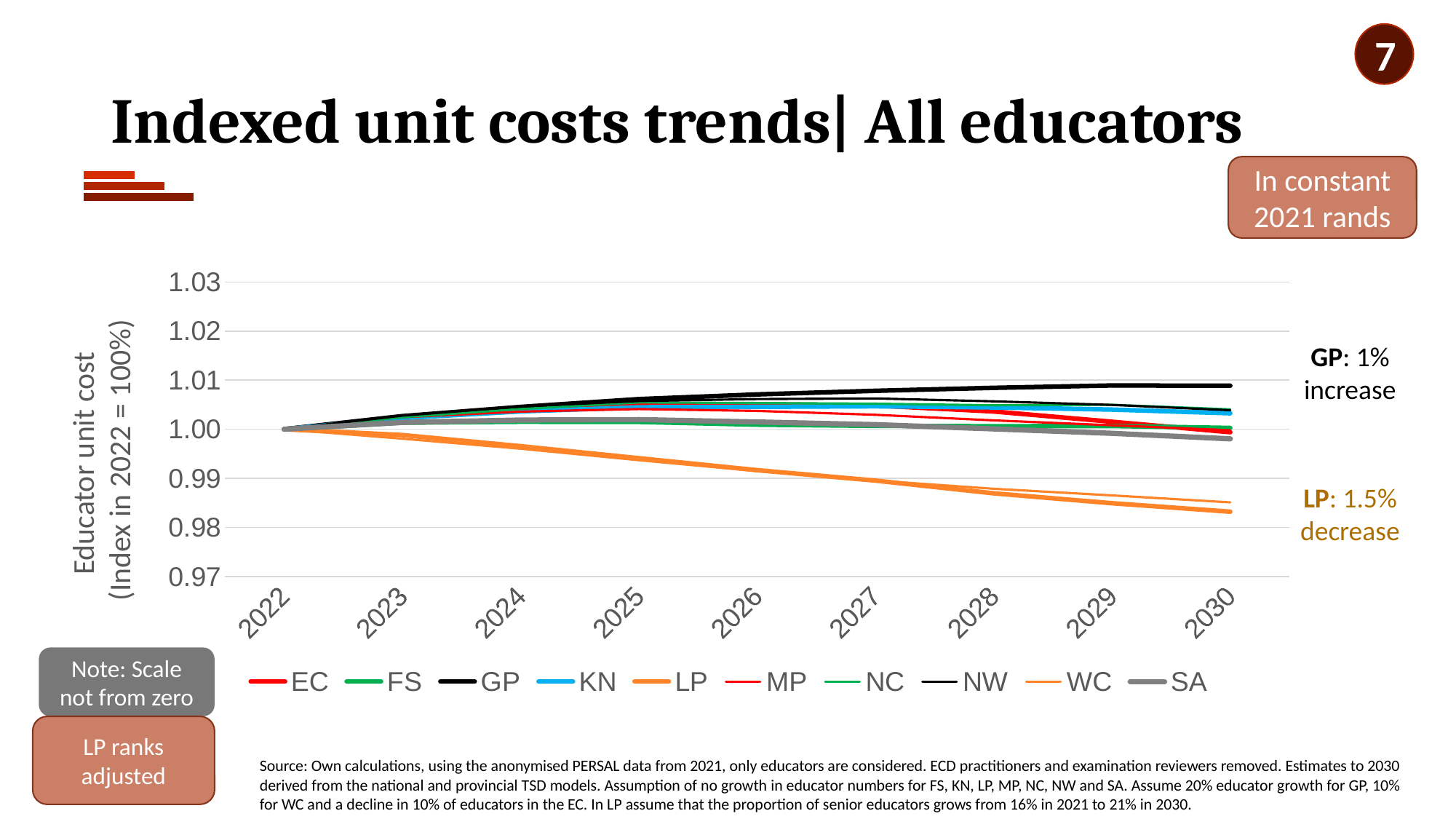
Does the GP line rise or fall from 2022 to 2030? rise Which series has the highest indexed unit cost in 2030? GP Does the LP line rise or fall from 2022 to 2030? fall How many years are shown along the x axis? 9 According to the annotation on the chart, what percentage change does LP show? 1.5% decrease Is the value for LP in 2030 greater or less than 0.99? less What is the title of the slide? Indexed unit costs trends| All educators Which is larger in 2030, the value for GP or the value for LP? GP Is the value for GP in 2030 greater or less than 1.00? greater What is the index value for all series in 2022? 1.00 How many series does the legend list? 10 What kind of chart is shown on the slide? line chart